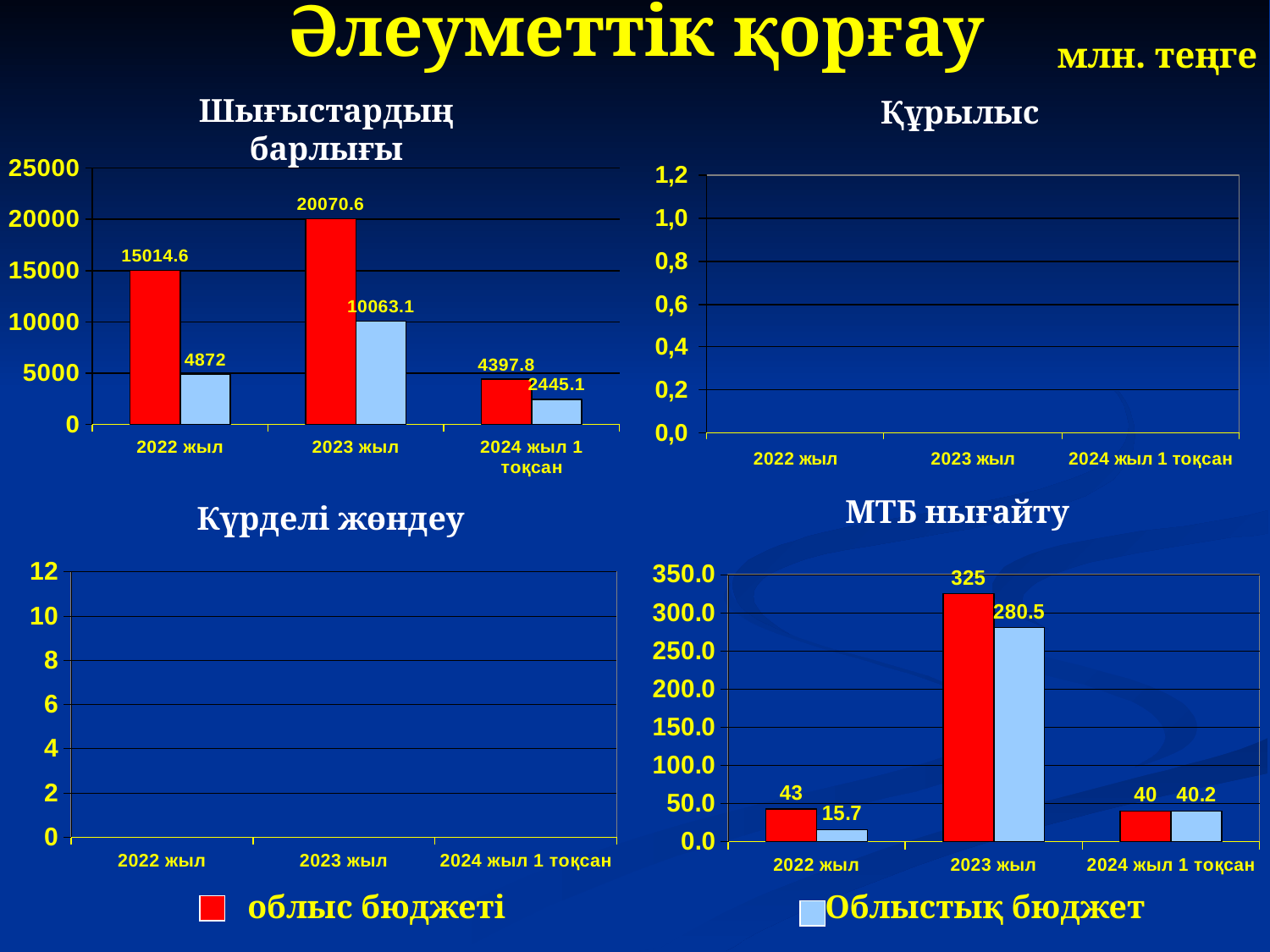
In the 'Шығыстардың барлығы' chart, which category has the highest red bar? 2023 жыл In the 'МТБ нығайту' chart, which is larger for 2024 жыл 1 тоқсан: the red bar or the light blue bar? the light blue bar What type of chart is 'Шығыстардың барлығы'? bar chart How many charts on the slide have no bars plotted? 2 In the 'Шығыстардың барлығы' chart, what is the value of the light blue bar for 2022 жыл? 4872 In the 'Шығыстардың барлығы' chart, which category has the lowest light blue bar? 2024 жыл 1 тоқсан How many categories are shown on the x axis of the 'МТБ нығайту' chart? 3 In the 'МТБ нығайту' chart, what is the value of the light blue bar for 2023 жыл? 280.5 In the 'МТБ нығайту' chart, what is the value of the red bar for 2022 жыл? 43 In the 'Шығыстардың барлығы' chart, what is the difference between the red and light blue bars for 2022 жыл? 10142.6 In the 'МТБ нығайту' chart, what is the difference between the red and light blue bars for 2023 жыл? 44.5 In the 'Шығыстардың барлығы' chart, what is the value of the red bar for 2023 жыл? 20070.6